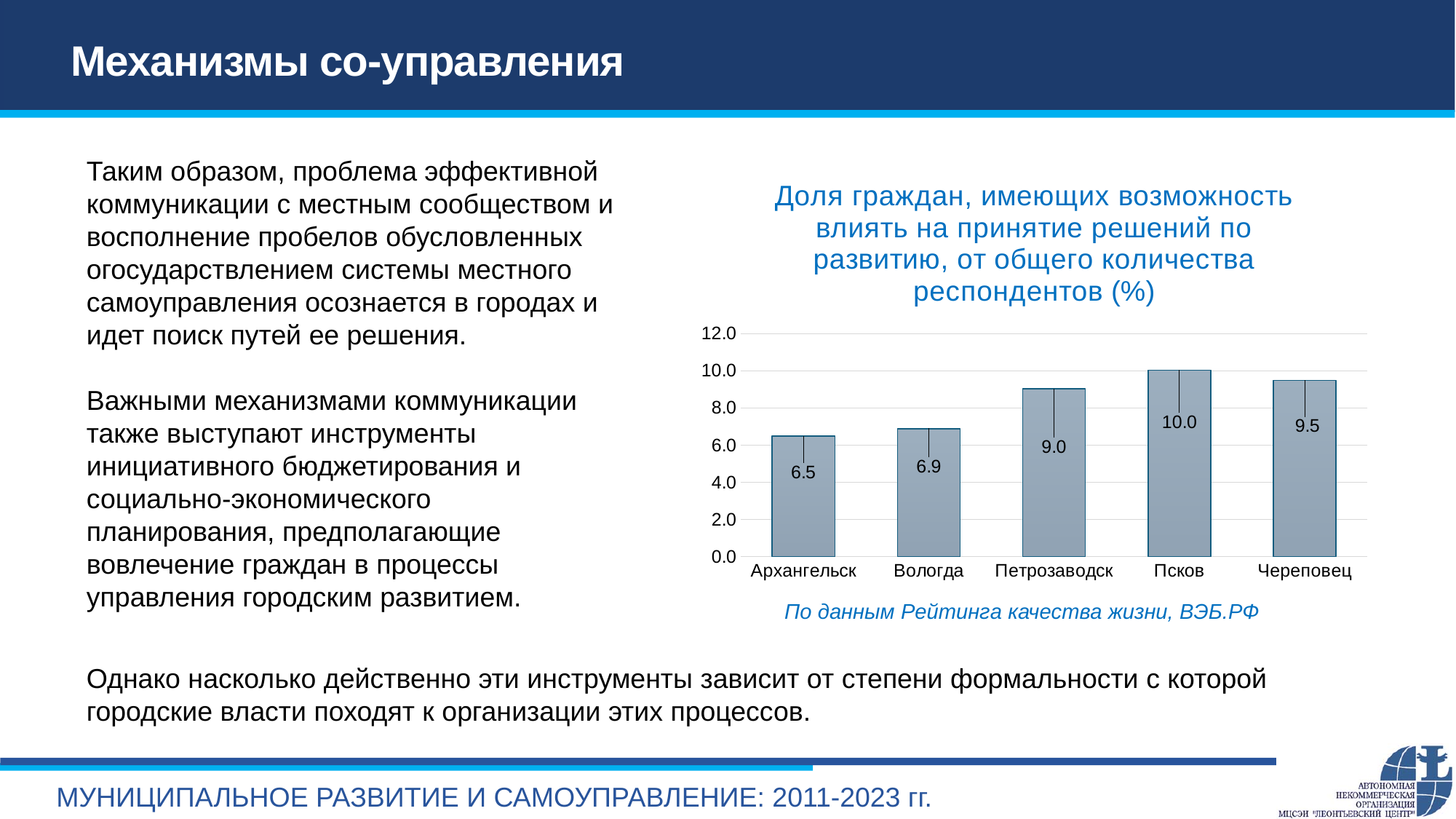
Which city has the lowest value? Архангельск How many cities are shown on the chart? 5 What is the difference between the values for Череповец and Вологда? 2.6 What kind of chart is shown on the slide? bar chart Which city has the highest value? Псков Which is larger, the value for Петрозаводск or the value for Вологда? Петрозаводск Is the value for Череповец greater or less than 8.0? greater What is the value for Псков? 10.0 What data source is cited below the chart? Рейтинг качества жизни, ВЭБ.РФ What is the value for Архангельск? 6.5 What is the value for Петрозаводск? 9.0 What is the difference between the values for Псков and Архангельск? 3.5